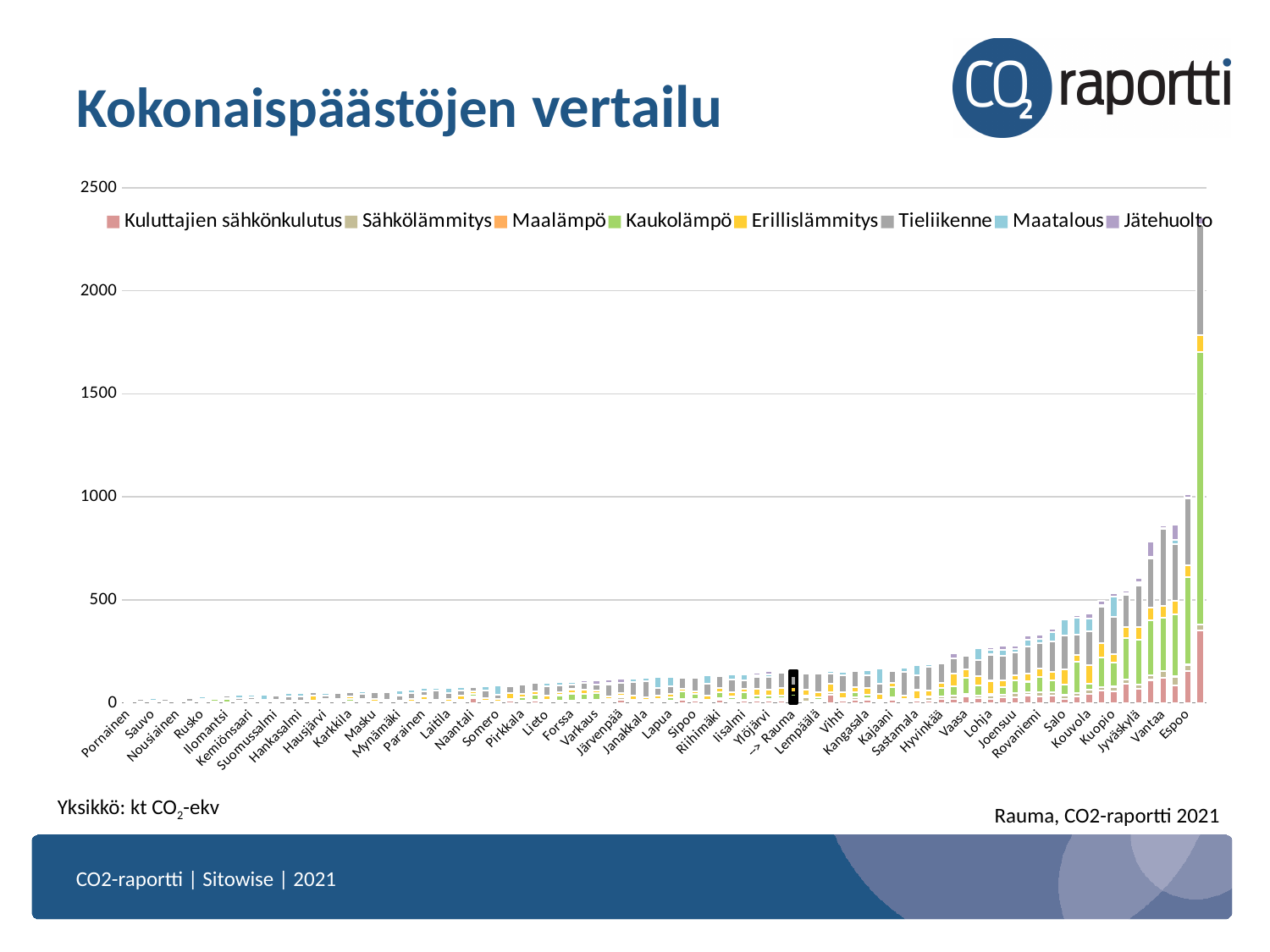
Is the total value for Rauma greater or less than 500? less Is the total value for Vantaa greater or less than 1000? less How many series does the legend list? 8 What is the title of the chart? Kokonaispäästöjen vertailu What unit is stated for the chart values? kt CO2-ekv Which has a larger total, Espoo or Vantaa? Espoo Do the bar totals rise or fall from left to right along the x axis? Rise Is the total value for Jyväskylä greater or less than 500? greater Which has a larger total, Kuopio or Rauma? Kuopio What kind of chart is shown on the slide? Stacked bar chart